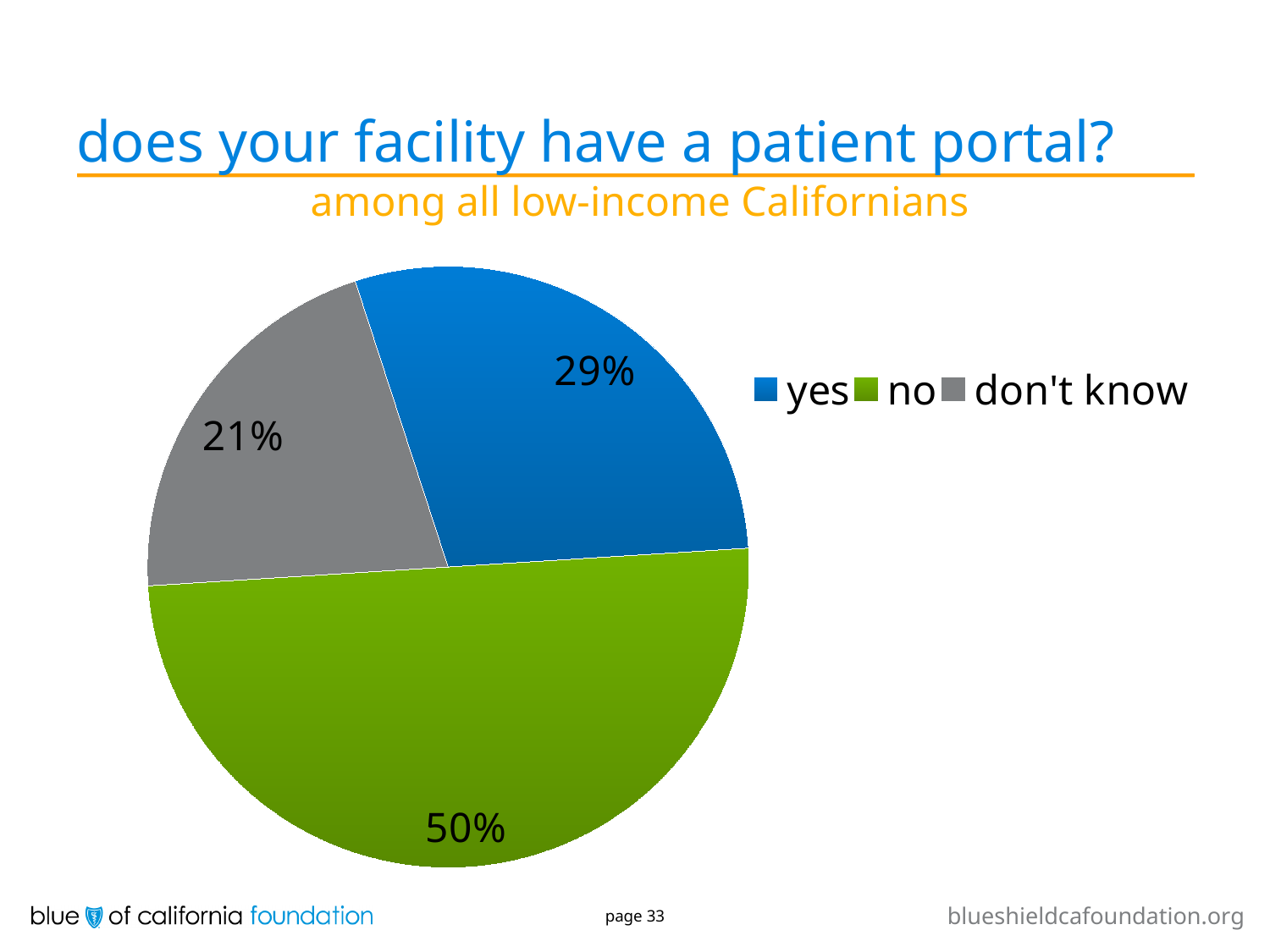
What percentage of respondents answered "don't know"? 21% Which is larger, the "yes" slice or the "don't know" slice? yes What percentage of respondents answered "yes"? 29% How many slices does the pie chart have? 3 What is the subtitle shown under the chart title? among all low-income Californians What kind of chart is shown on the slide? pie chart What percentage of respondents answered "no"? 50% What colour is the "no" slice? green What is the difference in percentage points between the "yes" and "don't know" slices? 8 What is the difference in percentage points between the "no" and "yes" slices? 21 Which response has the smallest share of the pie? don't know Which response has the largest share of the pie? no